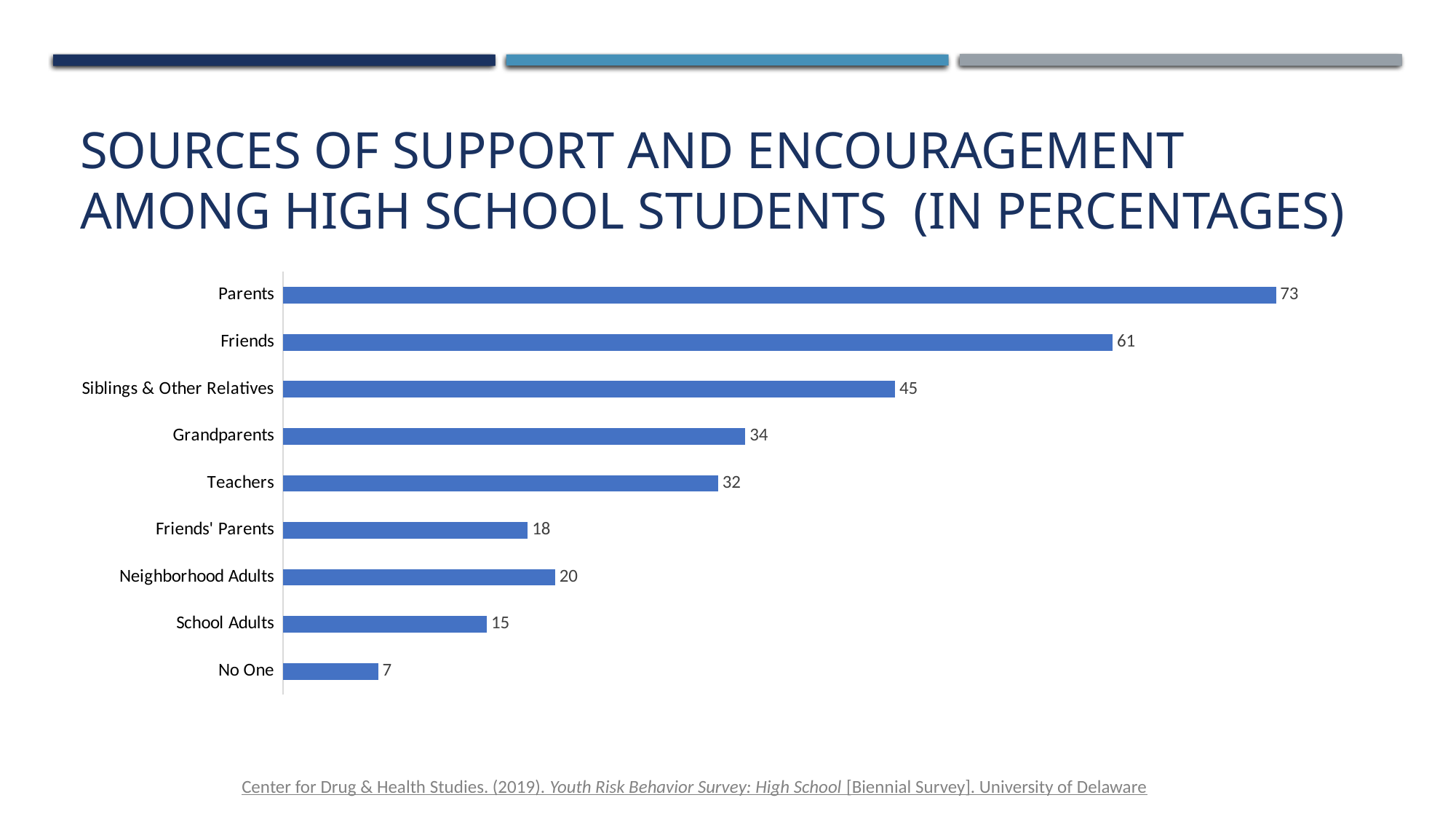
What is the value for School Adults? 15 What kind of chart is shown on the slide? Bar chart What is the value for Teachers? 32 Which category has the highest value? Parents What is the value for Parents? 73 How many categories are shown in the chart? 9 Which is larger, the value for Grandparents or the value for Teachers? Grandparents Which is larger, the value for Friends' Parents or the value for Neighborhood Adults? Neighborhood Adults Which category has the lowest value? No One What is the difference between the values for Siblings & Other Relatives and Grandparents? 11 What is the difference between the values for Parents and Friends? 12 What is the title of the slide? Sources of Support and Encouragement Among High School Students (in Percentages)